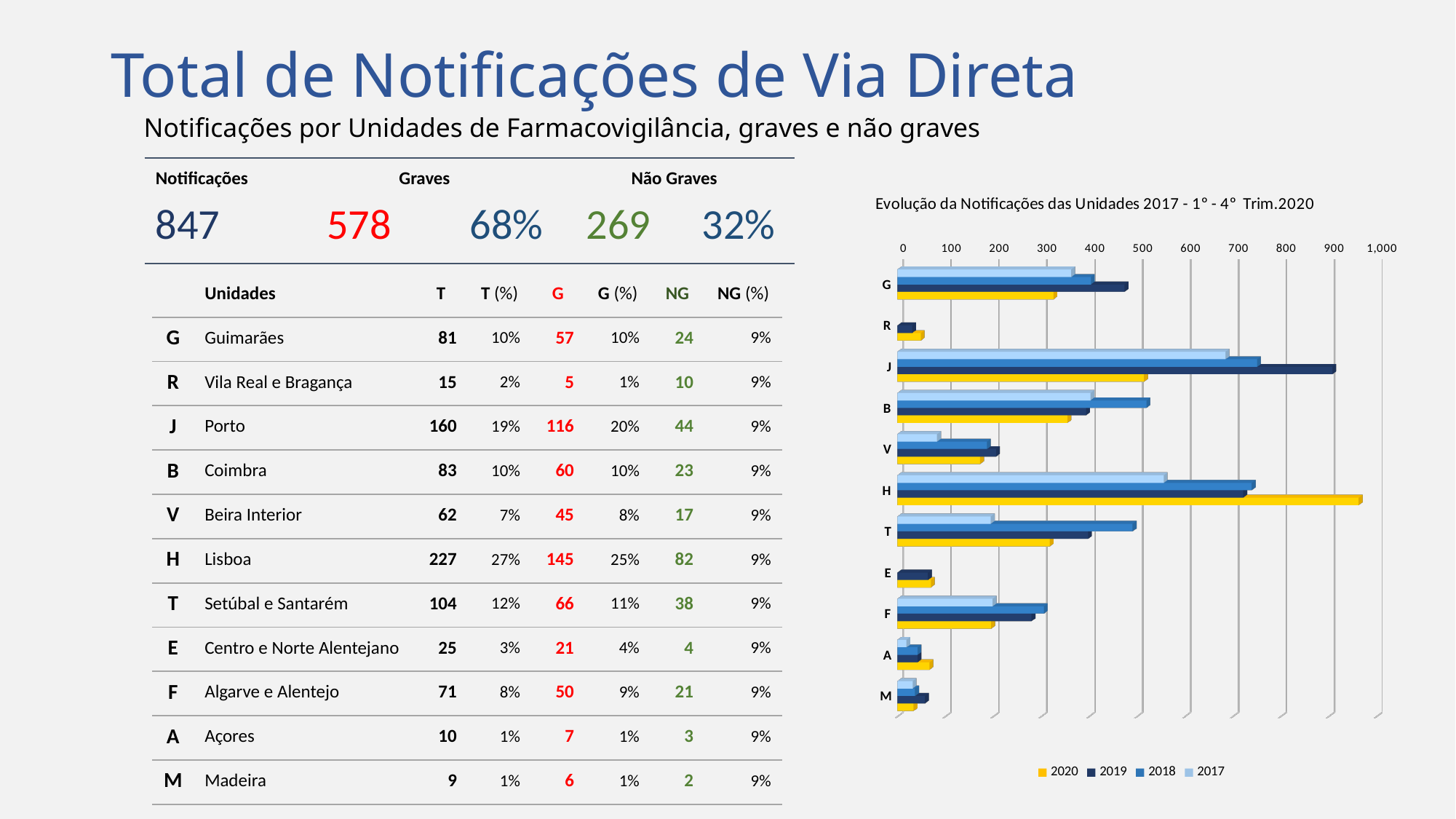
Is the 2019 value for G greater or less than 400? greater Is the 2020 value for H greater or less than 900? greater Which category has the longest 2019 bar in the chart? J How many series does the legend of the chart list? 4 What is the title of the chart? Evolução da Notificações das Unidades 2017 - 1° - 4° Trim.2020 How many categories are shown on the vertical axis of the chart? 11 Is the 2020 value for R greater or less than 100? less Which is larger in the chart, the 2019 value for J or the 2019 value for G? J Which is larger in the chart, the 2020 value for H or the 2020 value for J? H Which category has the longest 2020 bar in the chart? H What kind of chart is shown on the right side of the slide? bar chart